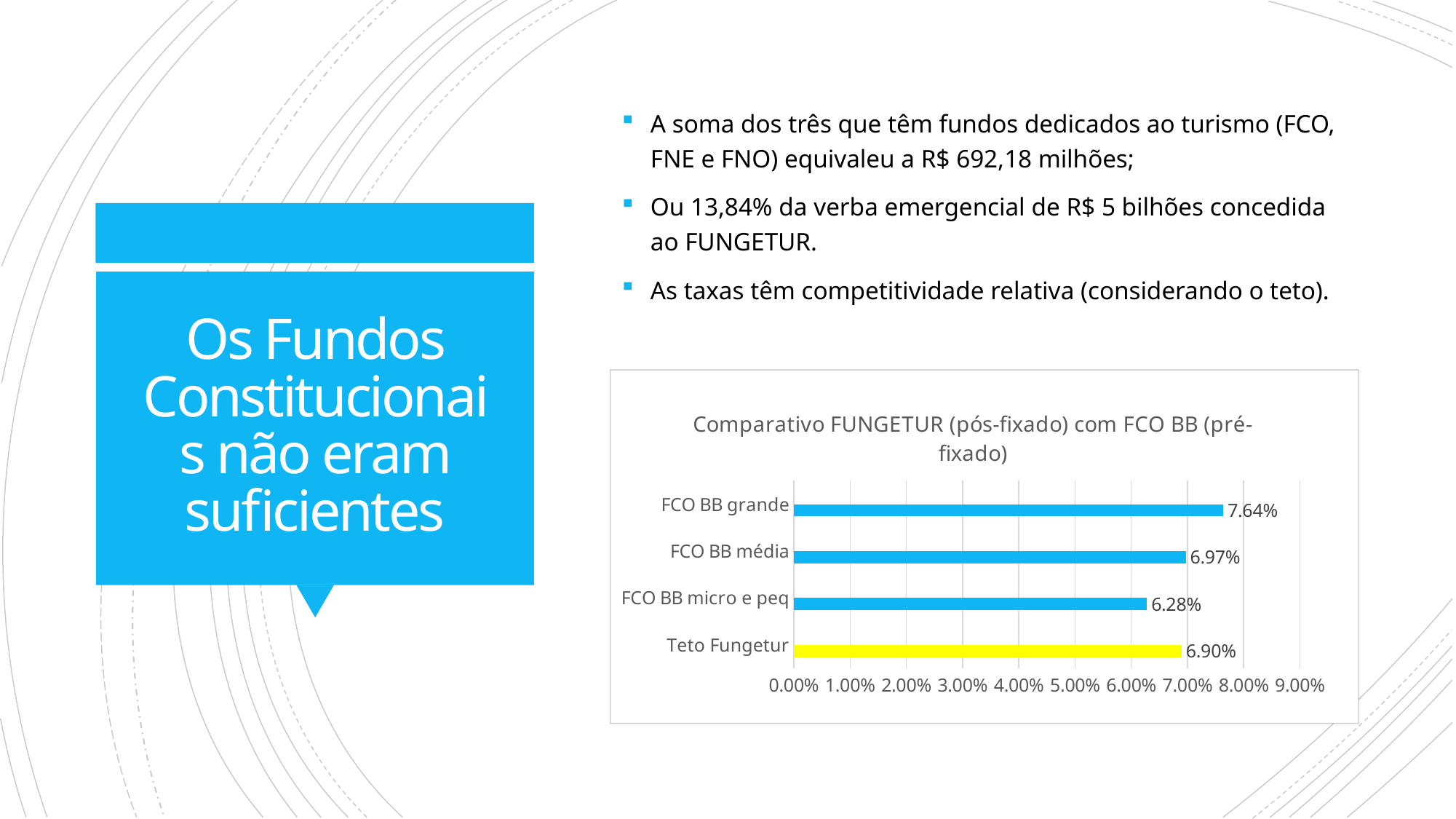
What is the difference between FCO BB grande and Teto Fungetur? 0.74% What is the value for Teto Fungetur? 6.90% Which bar is shown in yellow rather than blue? Teto Fungetur Which category has the highest value? FCO BB grande Which is larger, FCO BB micro e peq or Teto Fungetur? Teto Fungetur What is the difference between FCO BB média and FCO BB micro e peq? 0.69% What is the value for FCO BB média? 6.97% How many categories are shown in the chart? 4 What kind of chart is shown on the slide? Bar chart Which category has the lowest value? FCO BB micro e peq What is the value for FCO BB grande? 7.64% What is the value for FCO BB micro e peq? 6.28%